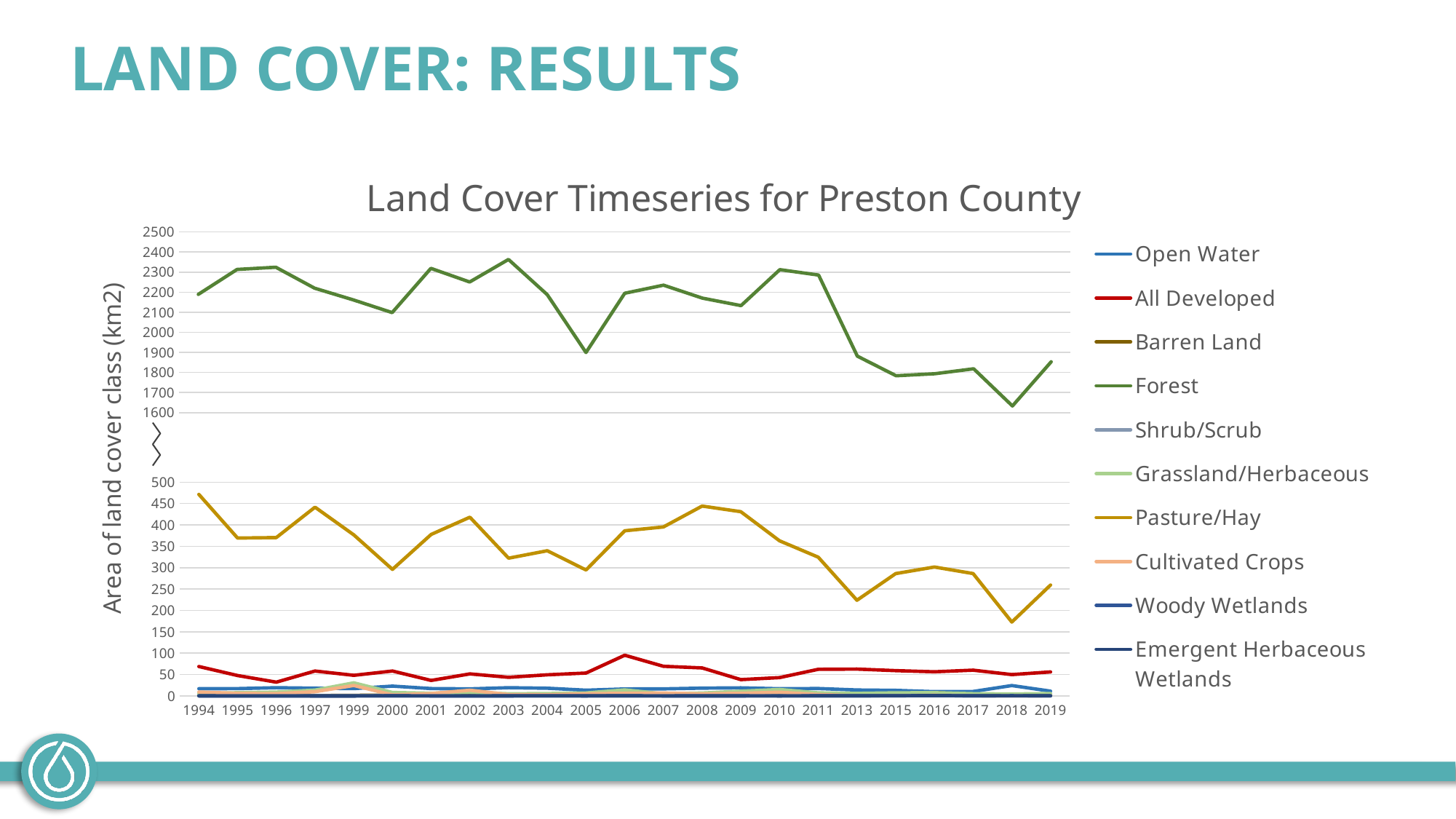
Is the value for All Developed in 2006 greater or less than 50? greater How many series does the legend list? 10 Is the value for Pasture/Hay in 2018 greater or less than 200? less Is the value for Forest in 2003 greater or less than 2300? greater How many years are shown along the x axis? 23 What kind of chart is shown on the slide? line chart In which year is the Forest area at its lowest? 2018 What is the title of the chart? Land Cover Timeseries for Preston County Which land cover class has the highest area across all years? Forest Does the Forest area overall rise or fall from 1994 to 2019? fall In which year is the Pasture/Hay area at its highest? 1994